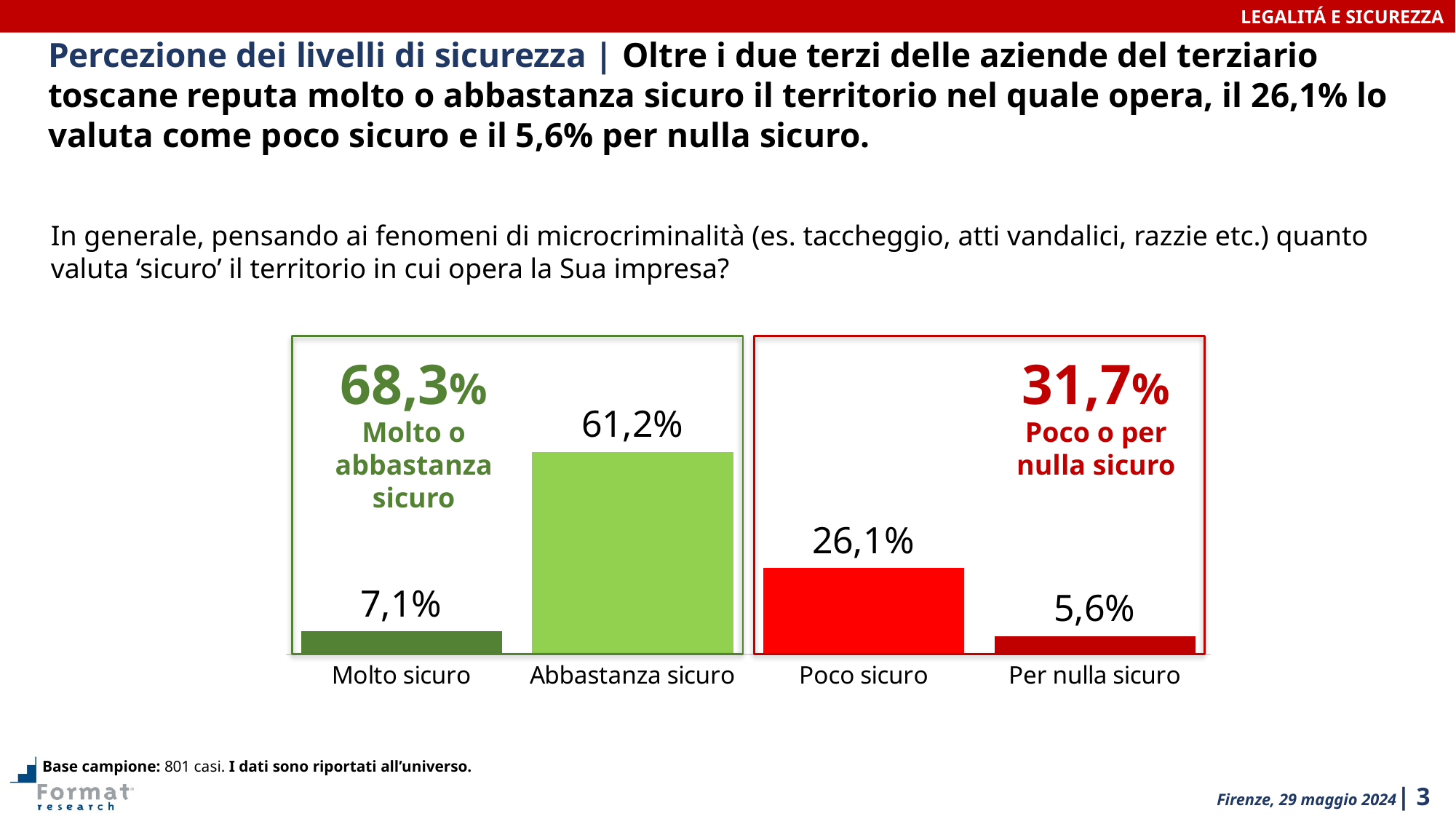
What kind of chart is shown on the slide? Bar chart Which is larger, Poco sicuro or Molto sicuro? Poco sicuro What combined percentage is shown for 'Molto o abbastanza sicuro'? 68,3% Which category has the highest value? Abbastanza sicuro Which category has the lowest value? Per nulla sicuro What is the value for Molto sicuro? 7,1% What is the value for Per nulla sicuro? 5,6% What is the value for Abbastanza sicuro? 61,2% What is the value for Poco sicuro? 26,1% What is the difference between Molto sicuro and Per nulla sicuro? 1,5% How many categories are shown in the chart? 4 What is the difference between Abbastanza sicuro and Poco sicuro? 35,1%